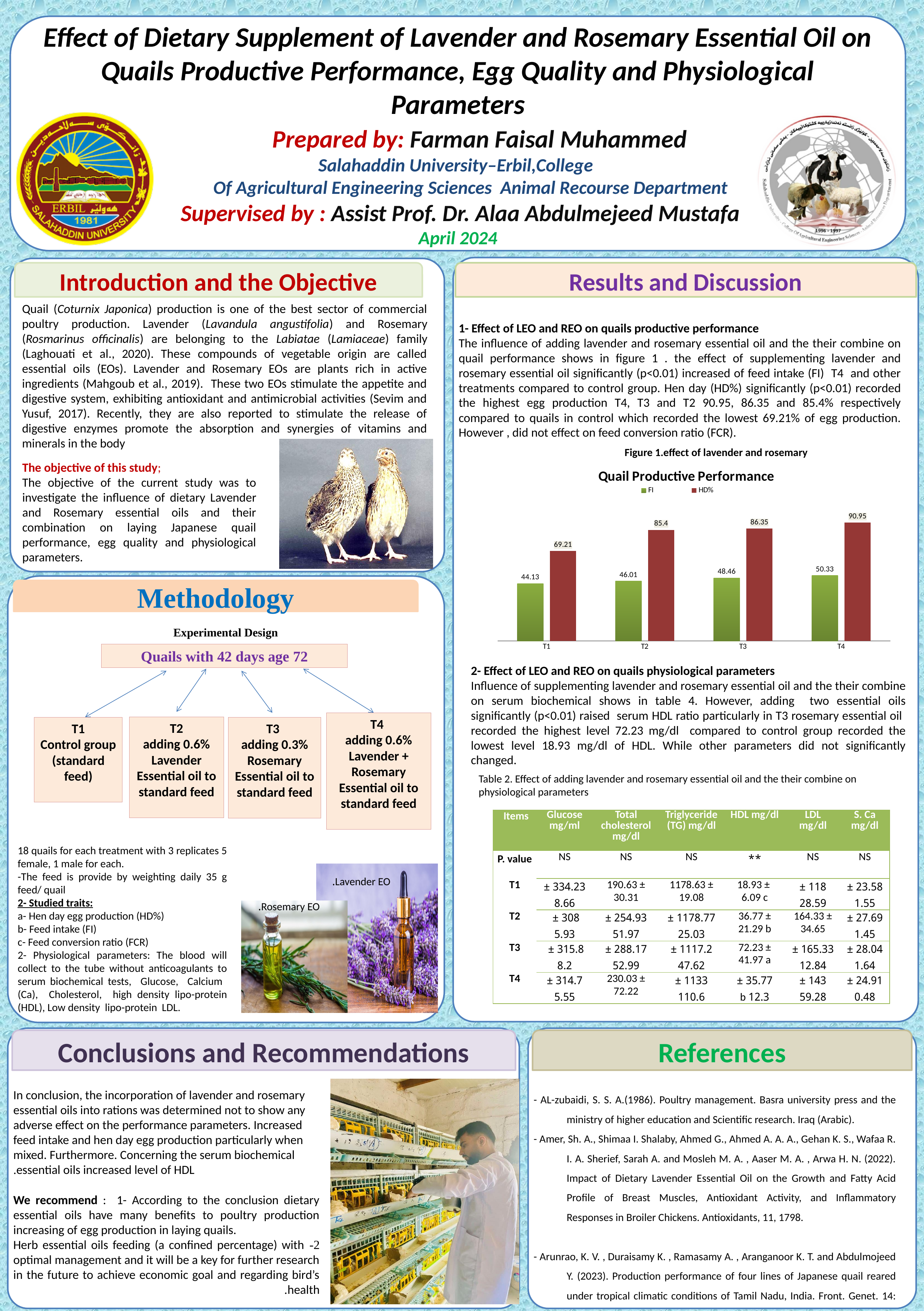
What is the difference between the HD% values of T4 and T1 in the Quail Productive Performance chart? 21.74 Which is larger in the Quail Productive Performance chart: the FI value for T4 or the FI value for T2? FI for T4 What is the FI value for T1 in the Quail Productive Performance chart? 44.13 What type of chart is the Quail Productive Performance chart? Bar chart How many series does the legend of the Quail Productive Performance chart list? 2 What is the FI value for T3 in the Quail Productive Performance chart? 48.46 Which treatment has the lowest FI value in the Quail Productive Performance chart? T1 Do the FI values rise or fall from T1 to T4 in the Quail Productive Performance chart? Rise Which treatment has the highest HD% value in the Quail Productive Performance chart? T4 What is the HD% value for T4 in the Quail Productive Performance chart? 90.95 How many treatment categories are shown on the x axis of the Quail Productive Performance chart? 4 What is the HD% value for T2 in the Quail Productive Performance chart? 85.4